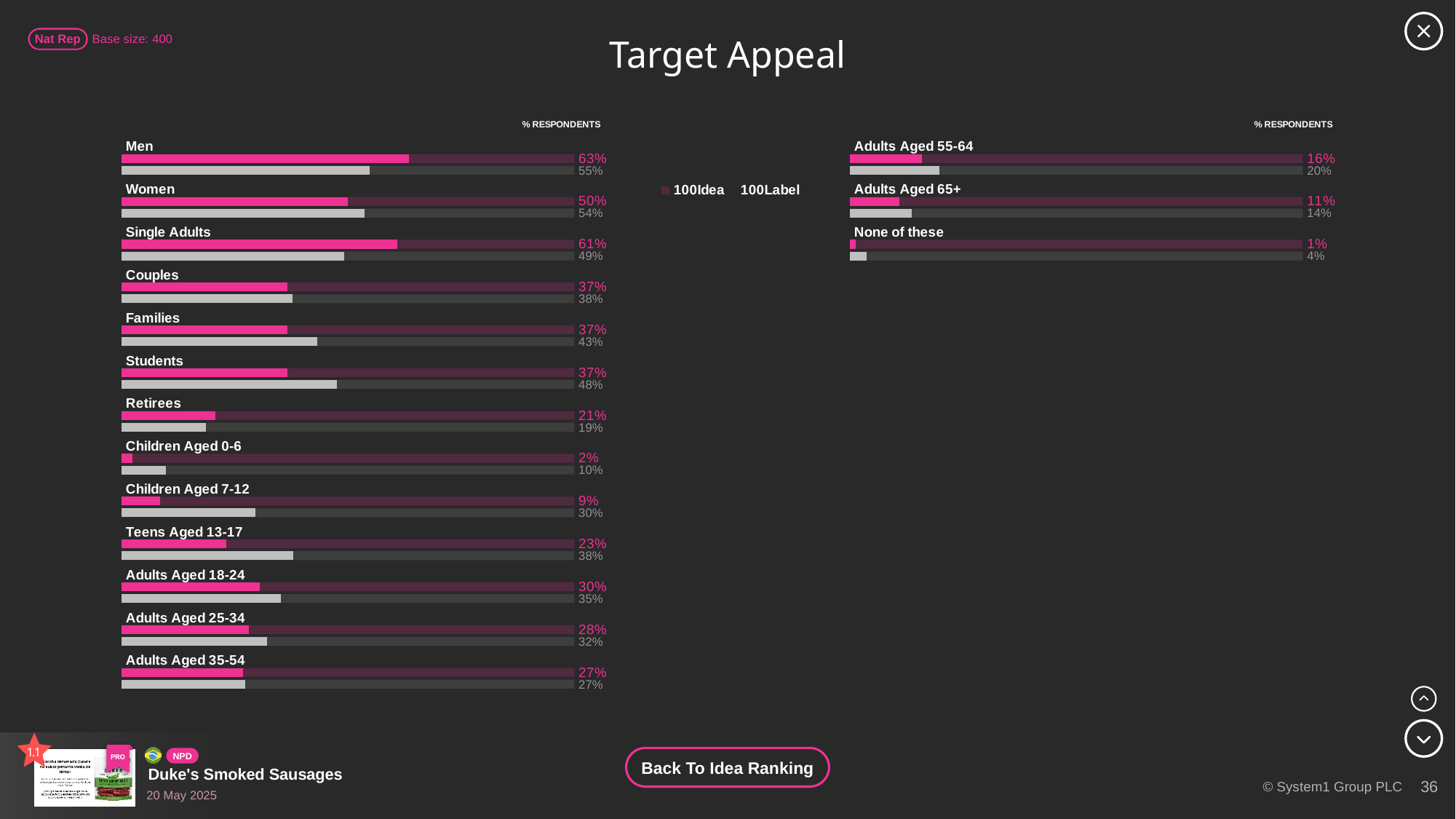
Which is larger for Teens Aged 13-17: the pink (top) bar value or the grey (bottom) bar value? Grey (bottom) bar, 38% What is the pink (top) bar value for Men? 63% Which is larger for Retirees: the pink (top) bar value or the grey (bottom) bar value? Pink (top) bar, 21% What type of chart is shown on the slide? Bar chart What is the grey (bottom) bar value for Students? 48% Which category has the highest pink (top) bar value? Men How many categories are shown in the chart? 16 What is the title of the slide? Target Appeal What is the difference between the grey (bottom) and pink (top) bar values for Children Aged 7-12? 21% Which category has the lowest pink (top) bar value? None of these What is the difference between the pink (top) bar values for Men and Women? 13% What is the pink (top) bar value for Adults Aged 65+? 11%